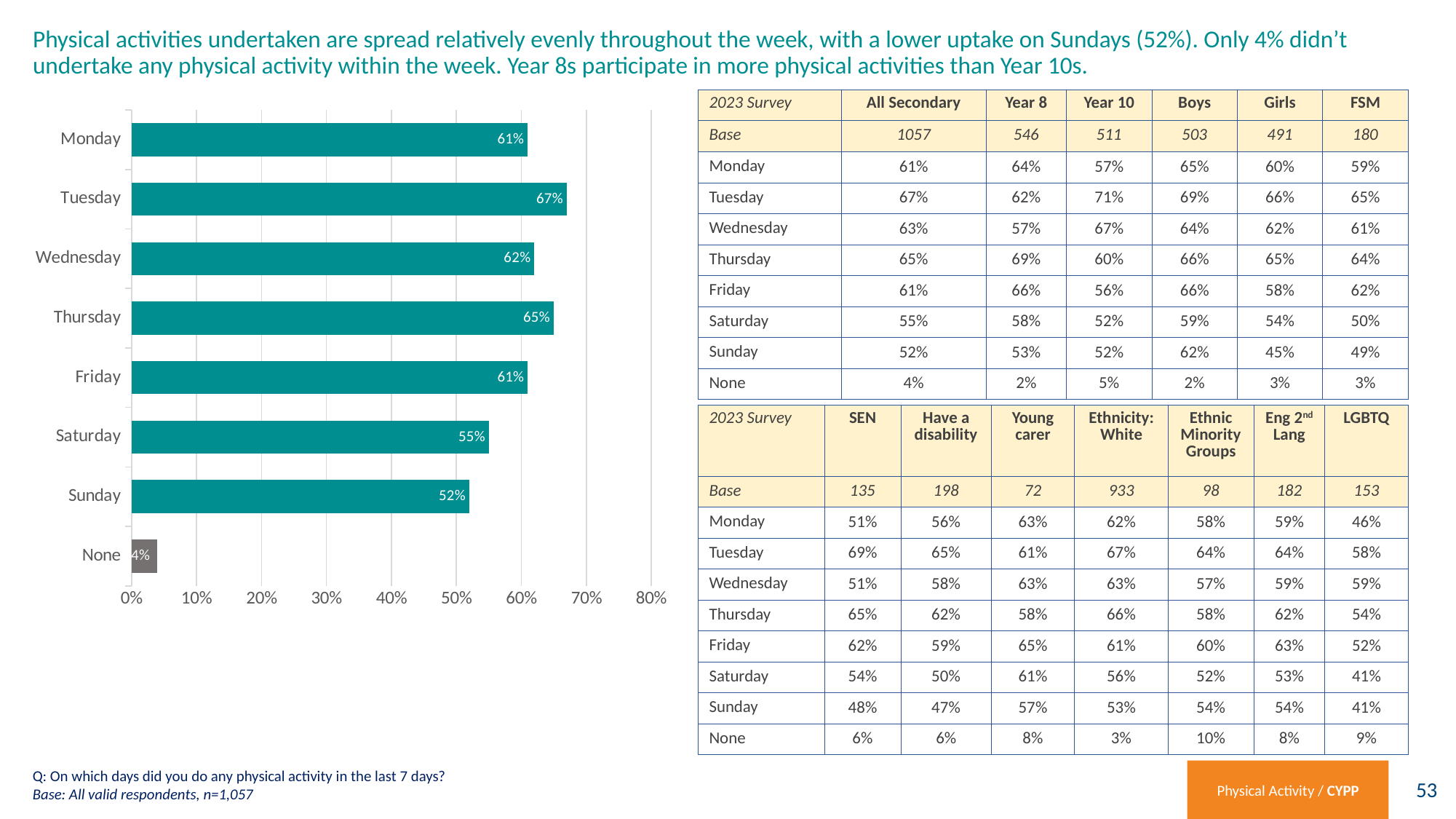
What is the value for None in the bar chart? 4% What is the difference between the values for Thursday and Wednesday in the bar chart? 3% What is the value for Sunday in the bar chart? 52% Which day has the highest value in the bar chart? Tuesday Is the value for Saturday in the bar chart greater or less than 60%? less What is the highest value shown on the x axis of the bar chart? 80% What is the difference between the values for Tuesday and Sunday in the bar chart? 15% What is the value for Tuesday in the bar chart? 67% How many categories are shown in the bar chart? 8 Which is larger in the bar chart, the value for Thursday or the value for Saturday? Thursday What kind of chart is shown on the slide? bar chart Which category has the lowest value in the bar chart? None